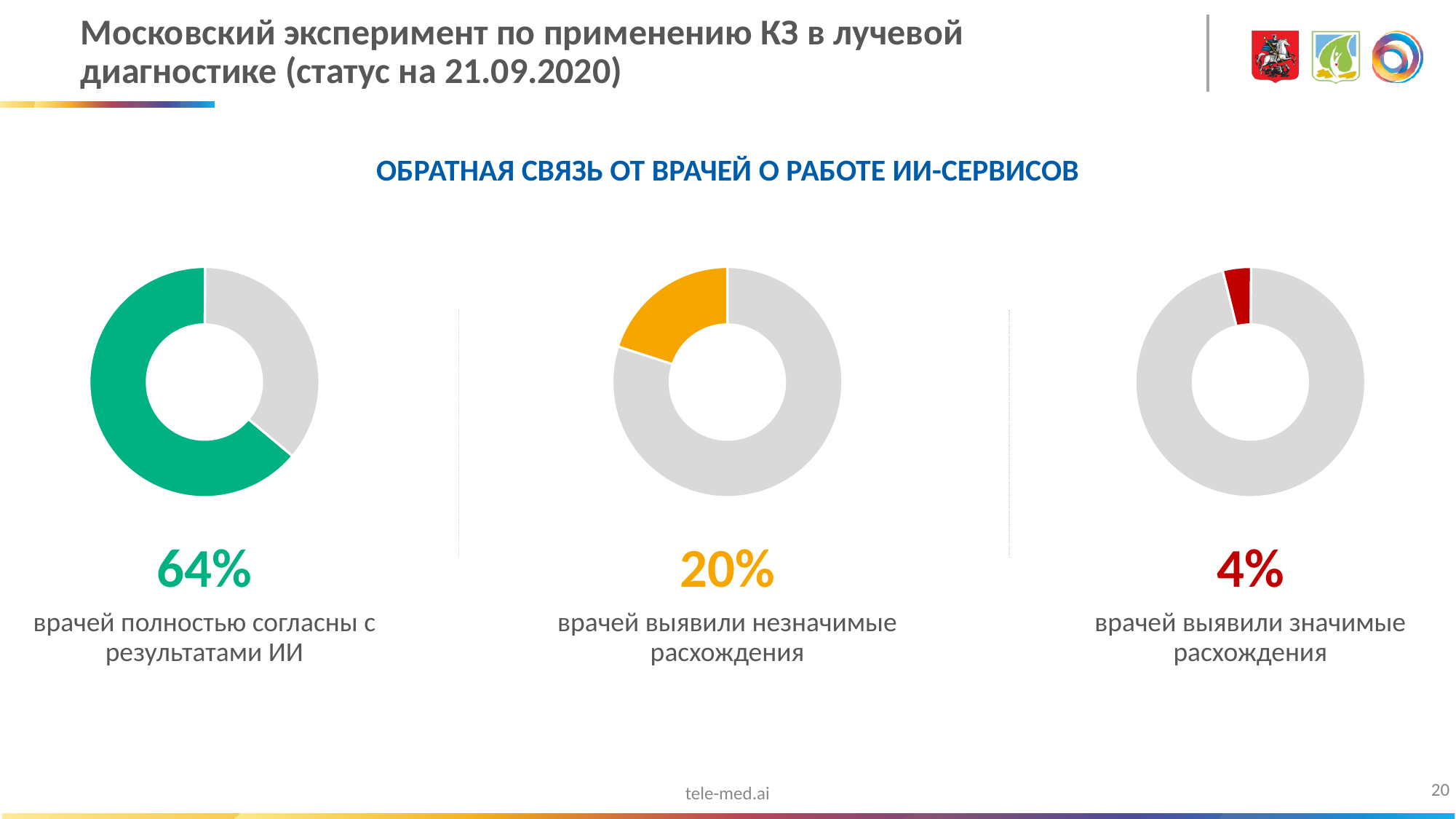
What colour is the highlighted segment of the right donut chart (4%)? Red On the middle donut chart, what share of doctors identified insignificant discrepancies (выявили незначимые расхождения)? 20% On the right donut chart, what share of doctors identified significant discrepancies (выявили значимые расхождения)? 4% What kind of charts are shown on the slide? Donut (pie) charts On the left donut chart, what share of doctors fully agreed with the AI results (врачей полностью согласны с результатами ИИ)? 64% What is the heading above the three donut charts? ОБРАТНАЯ СВЯЗЬ ОТ ВРАЧЕЙ О РАБОТЕ ИИ-СЕРВИСОВ What is the difference between the percentage on the middle chart (20%) and the percentage on the right chart (4%)? 16% Which of the three donut charts shows the lowest percentage? The right chart (4%, врачей выявили значимые расхождения) How many donut charts are shown on the slide? 3 Which is larger: the share of doctors who identified insignificant discrepancies (middle chart) or the share who identified significant discrepancies (right chart)? Insignificant discrepancies (middle chart, 20%) What is the difference between the percentage on the left chart (64%) and the percentage on the middle chart (20%)? 44% Which of the three donut charts shows the highest percentage? The left chart (64%, врачей полностью согласны с результатами ИИ)